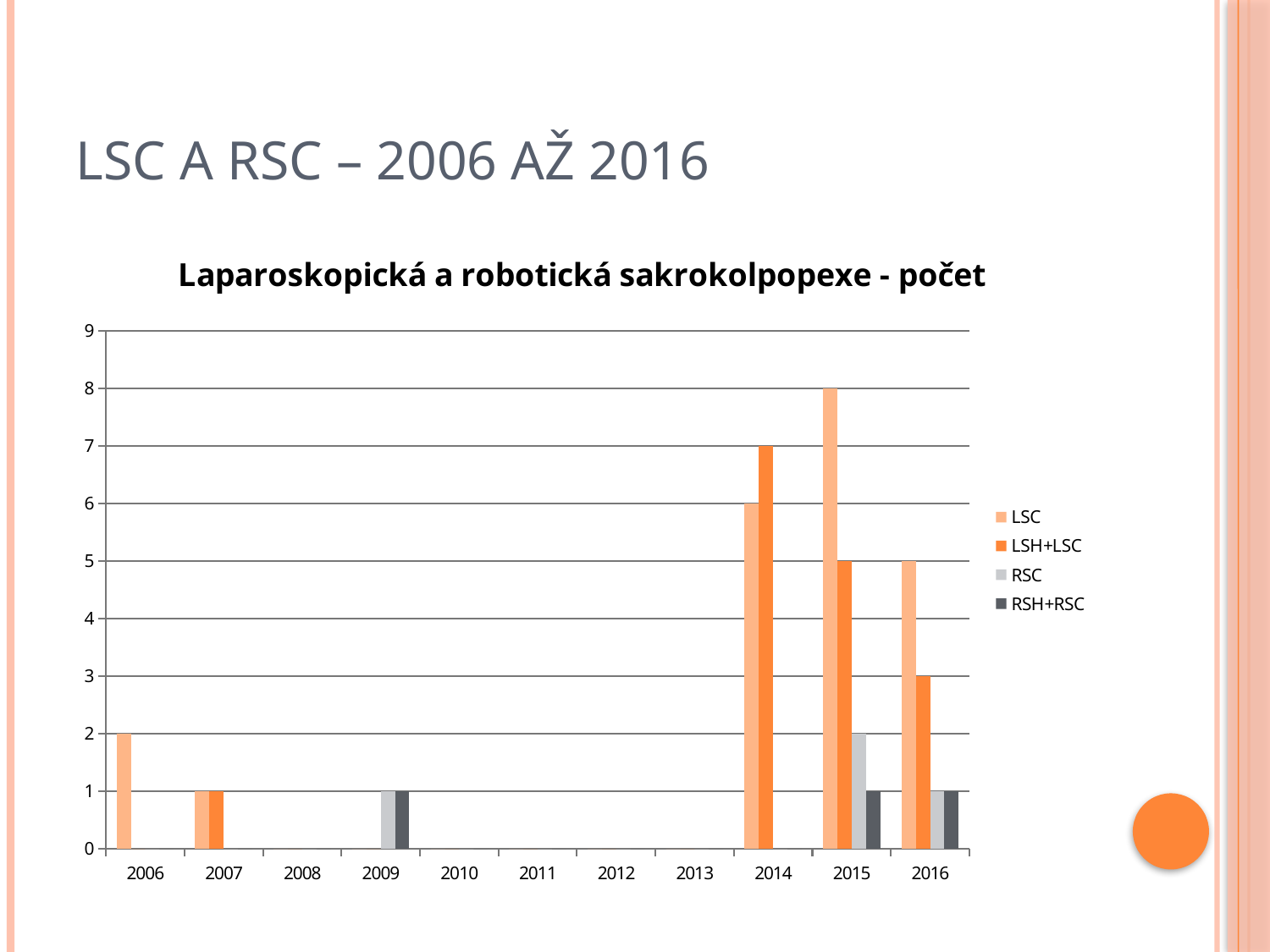
In which year is the LSC value highest? 2015 How many series does the legend list? 4 Which is larger in 2014, LSC or LSH+LSC? LSH+LSC What is the RSC value for 2015? 2 How many years are shown on the x axis? 11 What is the LSC value for 2006? 2 What is the LSH+LSC value for 2014? 7 Is the LSH+LSC value for 2016 greater or less than 4? less What is the LSC value for 2015? 8 What is the title of the chart? Laparoskopická a robotická sakrokolpopexe - počet What is the difference between the LSC values for 2015 and 2016? 3 What kind of chart is shown on the slide? bar chart